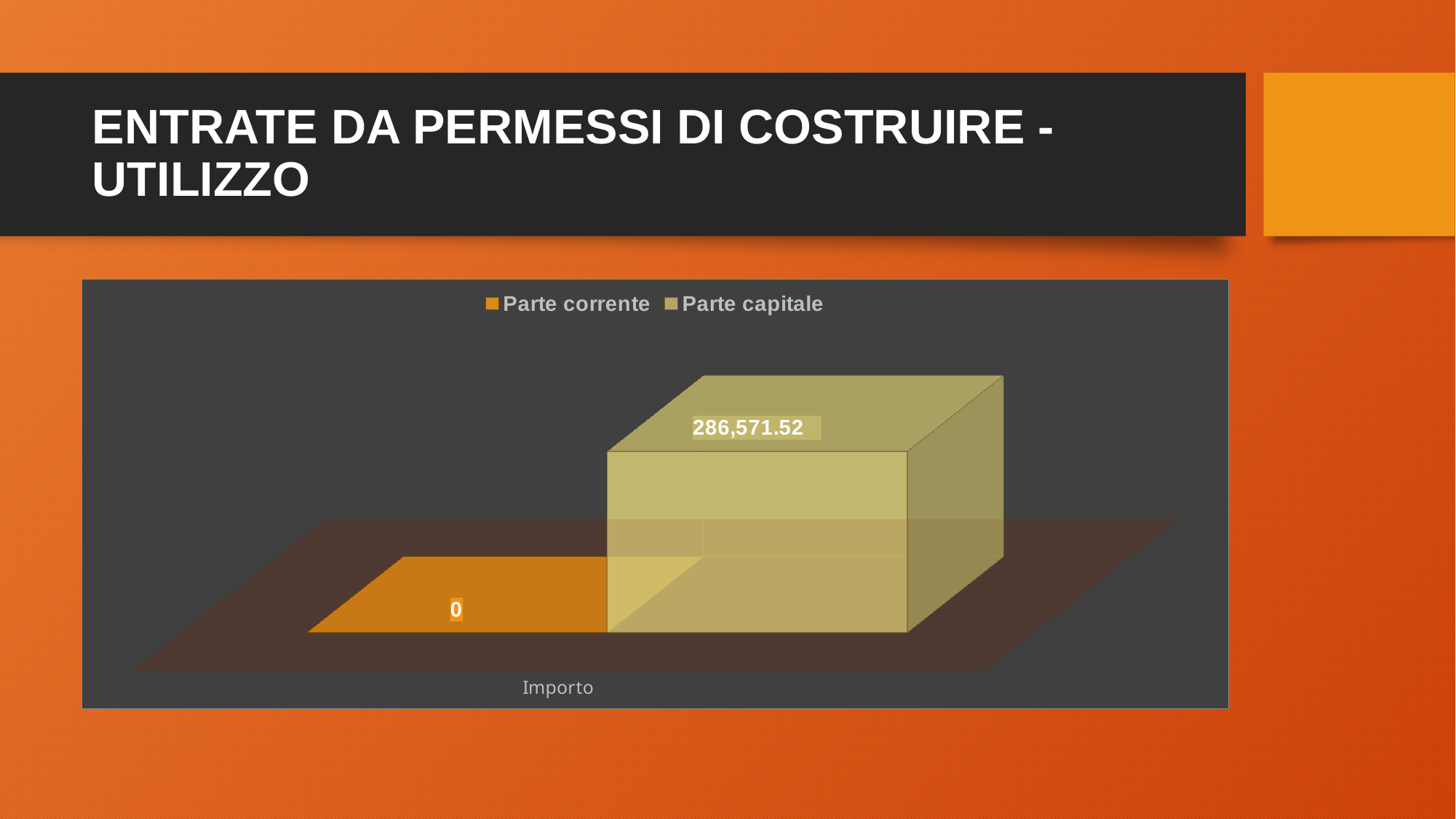
How many categories are shown on the x axis? 1 Which colour represents Parte corrente in the legend? Orange What is the value for Parte corrente? 0 How many series does the legend list? 2 What is the total of Parte corrente and Parte capitale? 286,571.52 Which series has the highest value? Parte capitale Which is larger, Parte corrente or Parte capitale? Parte capitale What kind of chart is shown on the slide? Bar chart What is the value for Parte capitale? 286,571.52 Which series has the lowest value? Parte corrente What is the difference between Parte capitale and Parte corrente? 286,571.52 What is the label of the category on the x axis? Importo